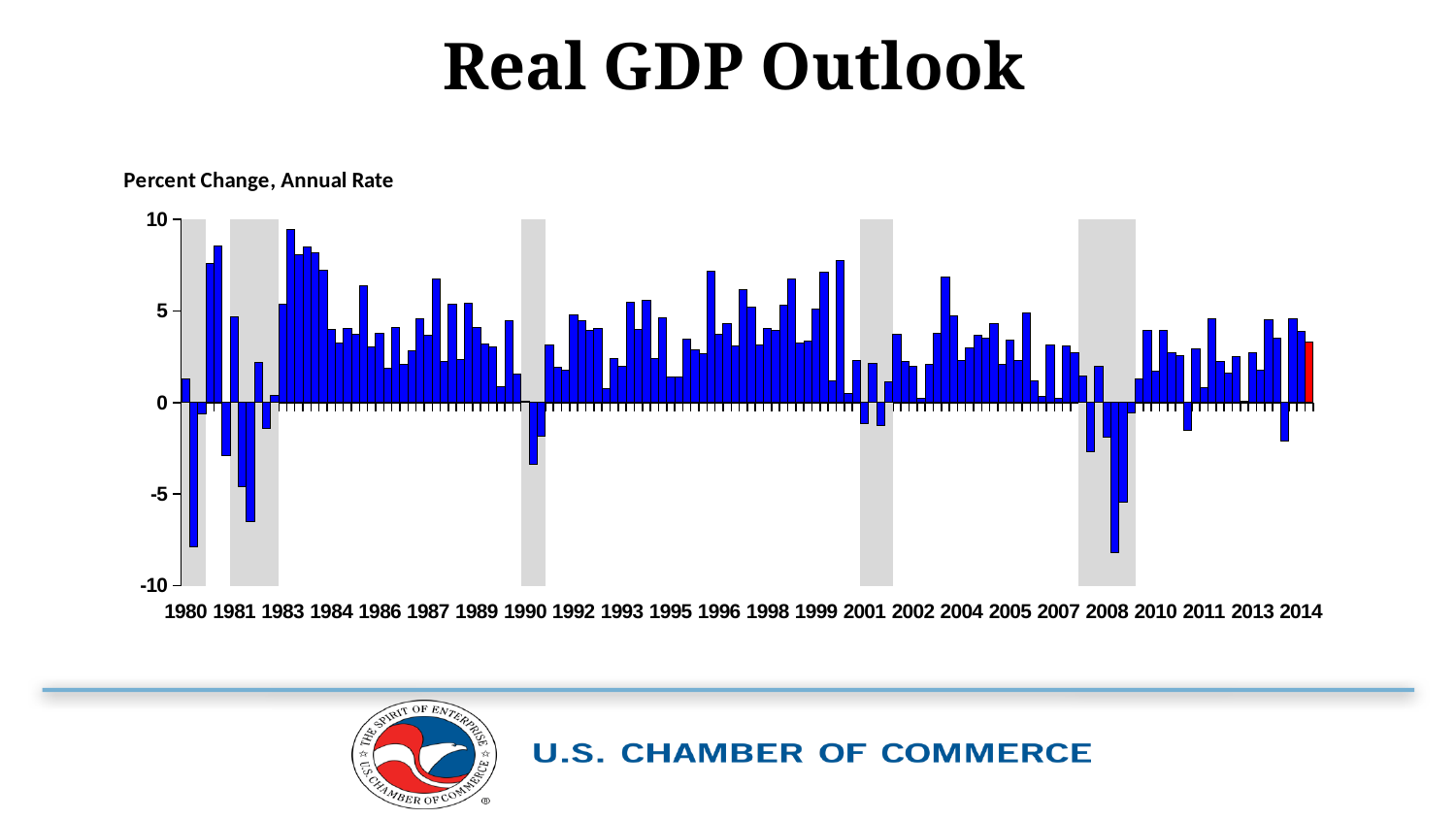
Is the value of the red bar for 2014 greater or less than 0? greater Is the highest value in 1981 greater or less than 5? greater What is the title of the chart on the slide? Real GDP Outlook Is the lowest value in 2008 greater or less than -5? less What kind of chart is shown on the slide? bar chart What is the highest value shown on the vertical axis? 10 What colour is the final bar (2014) in the chart? red